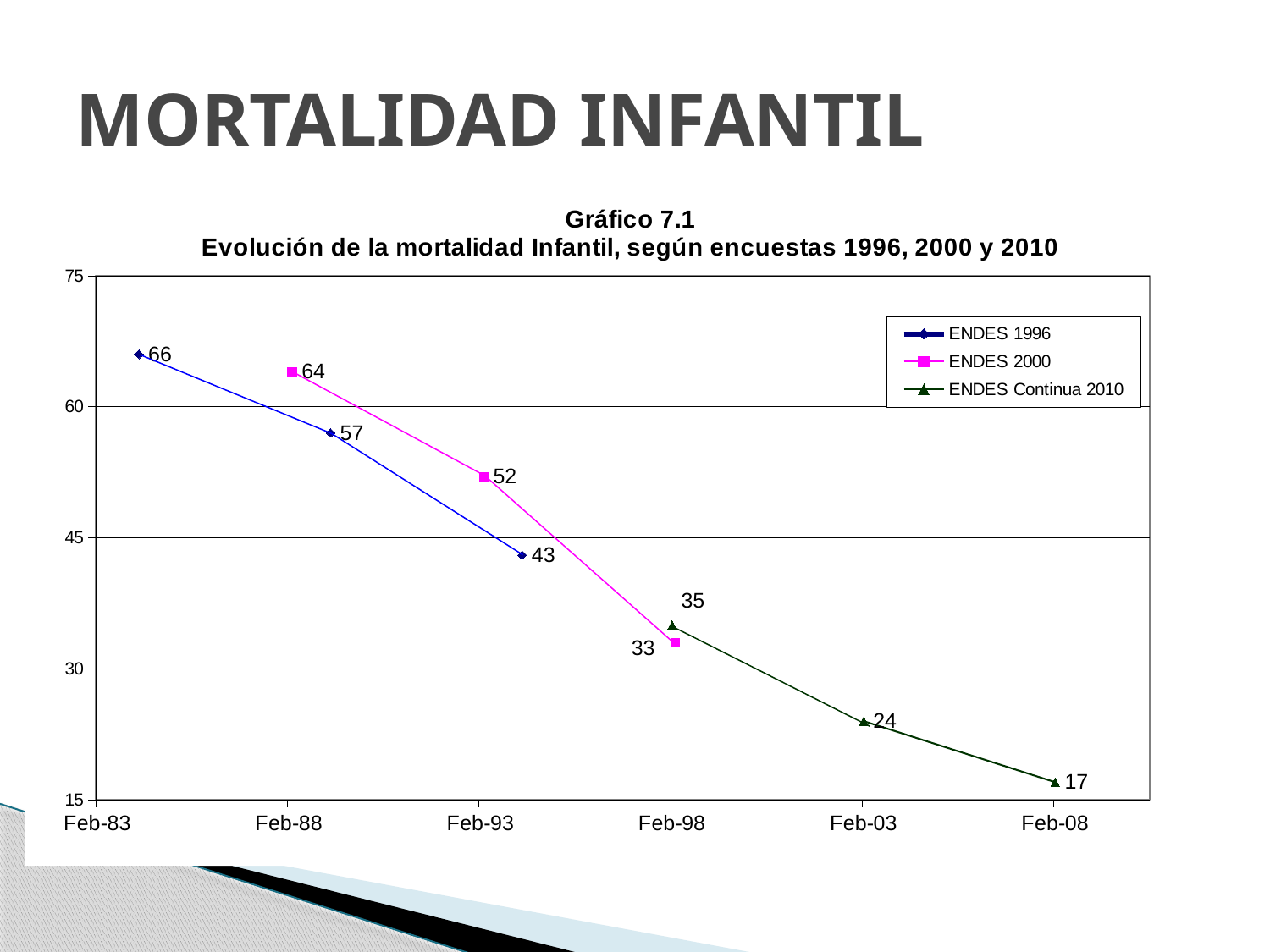
How many data points does the ENDES 2000 series have? 3 Which is larger: the last point of ENDES 2000 (33) or the first point of ENDES Continua 2010 (35)? ENDES Continua 2010 (35) Do the values of the ENDES Continua 2010 series rise or fall along the x axis? fall What is the lowest value plotted on the chart? 17 How many series does the legend list? 3 What is the highest value plotted on the chart? 66 What is the value of the middle point of the ENDES 2000 series? 52 What is the value of the first (leftmost) point of the ENDES 1996 series? 66 What is the difference between the first and last points of the ENDES 1996 series (66 and 43)? 23 What is the value of the last (rightmost) point of the ENDES Continua 2010 series? 17 What kind of chart is shown on the slide? line chart What is the title of the chart? Gráfico 7.1 Evolución de la mortalidad Infantil, según encuestas 1996, 2000 y 2010